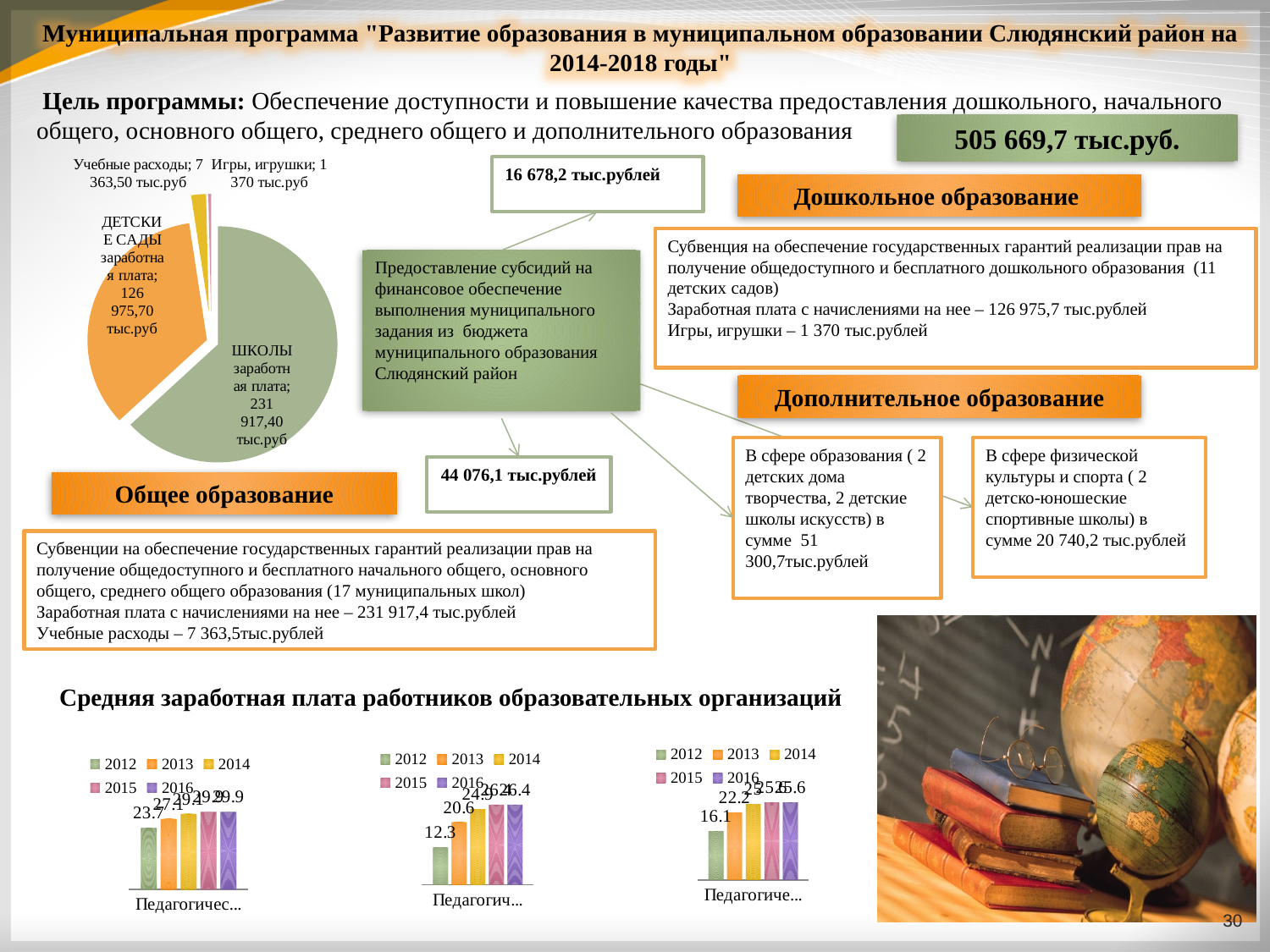
What kind of chart is the chart at the top left of the slide? pie chart In the rightmost bar chart at the bottom of the slide, which is larger, the value for 2012 or the value for 2013? 2013 In the pie chart at the top left, what is the value for ДЕТСКИЕ САДЫ заработная плата? 126 975,70 тыс.руб In the pie chart at the top left, which slice is the smallest? Игры, игрушки In the middle bar chart at the bottom of the slide, what is the value for 2012? 12.3 In the pie chart at the top left, what is the value for Игры, игрушки? 1 370 тыс.руб In the leftmost bar chart at the bottom of the slide, what is the value for 2012? 23.7 How many slices does the pie chart at the top left have? 4 In the pie chart at the top left, which slice is the largest? ШКОЛЫ заработная плата In the pie chart at the top left, what is the difference between ШКОЛЫ заработная плата and ДЕТСКИЕ САДЫ заработная плата? 104 941,70 тыс.руб In the pie chart at the top left, what is the value for ШКОЛЫ заработная плата? 231 917,40 тыс.руб How many series does the legend of the leftmost bar chart at the bottom of the slide list? 5